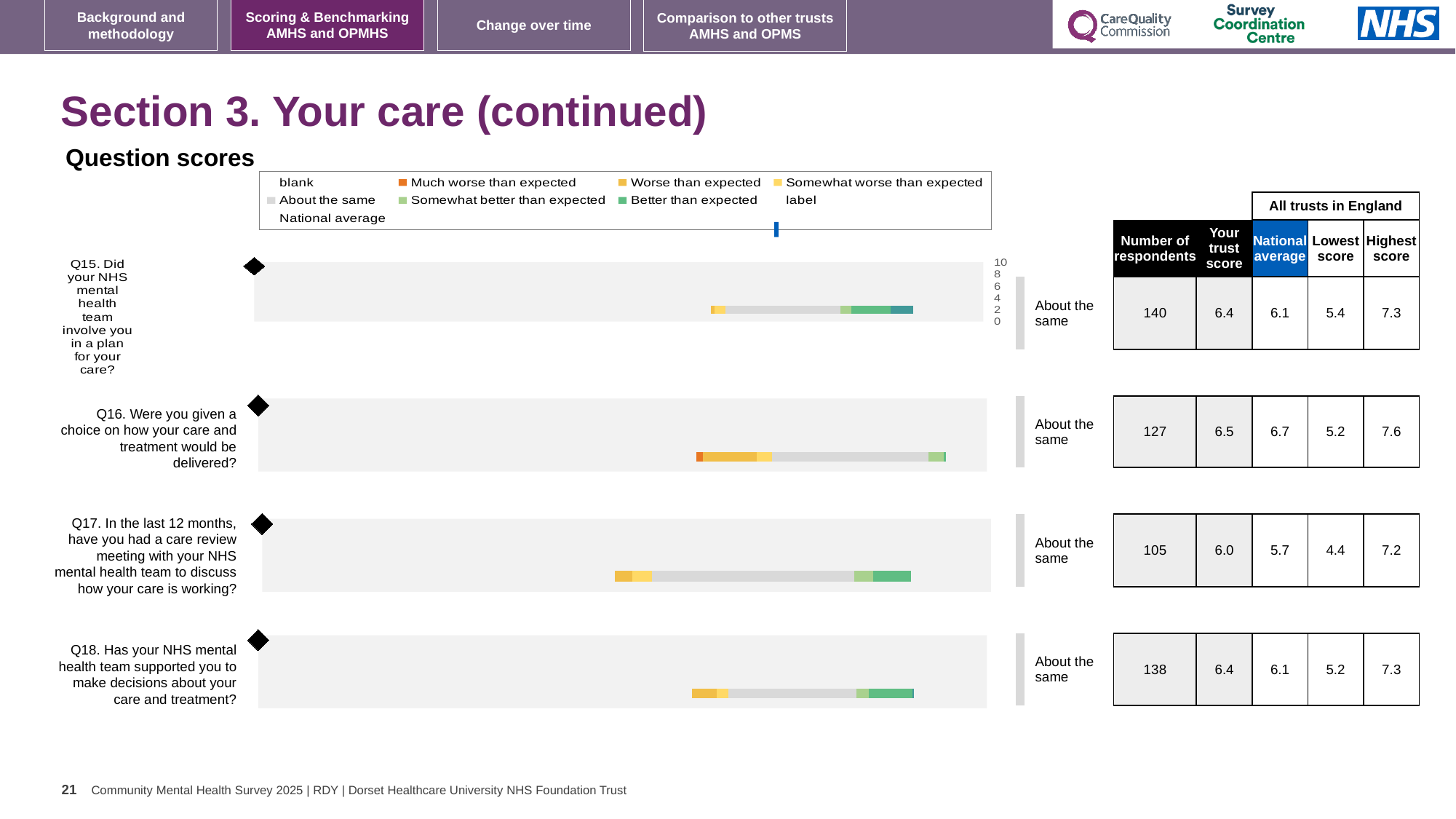
For Q17, what is the difference between the highest score and the lowest score across all trusts in England? 2.8 What is the national average score for Q17? 5.7 What is the number of respondents for Q15? 140 What is the trust score for Q16 (choice on how care and treatment would be delivered)? 6.5 Which question has the highest number of respondents? Q15 What benchmark label is shown next to the bar for Q16? About the same How many questions (Q15 to Q18) have a bar plotted on the slide? 4 What is the highest score across all trusts in England for Q18? 7.3 In the legend, which category is shown in dark orange? Much worse than expected Which question has the lowest 'Lowest score' across all trusts in England? Q17 For Q16, which is larger: the trust score or the national average? national average What kind of chart is used to show the question scores for Q15 to Q18? bar chart